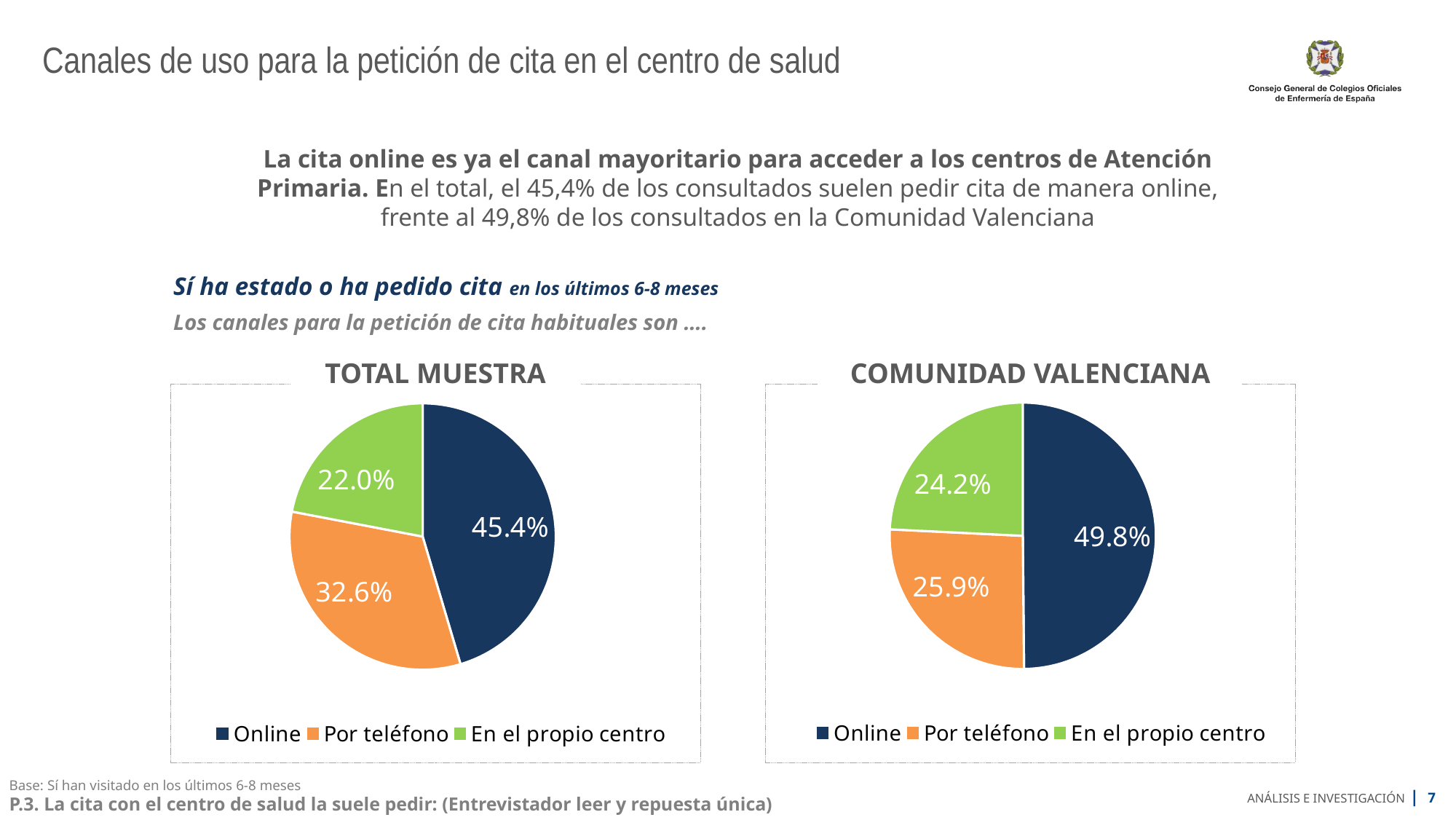
In the TOTAL MUESTRA chart, what percentage is shown for Online? 45.4% In the TOTAL MUESTRA chart, what is the difference between the Online and Por teléfono percentages? 12.8% In the TOTAL MUESTRA chart, what percentage is shown for Por teléfono? 32.6% In the COMUNIDAD VALENCIANA chart, what percentage is shown for Por teléfono? 25.9% In the COMUNIDAD VALENCIANA chart, what is the difference between the Online and En el propio centro percentages? 25.6% What type of chart is used in the TOTAL MUESTRA chart? Pie chart Which chart shows a higher percentage for Online, TOTAL MUESTRA or COMUNIDAD VALENCIANA? COMUNIDAD VALENCIANA In the TOTAL MUESTRA chart, which category has the largest slice? Online In the COMUNIDAD VALENCIANA chart, which category has the largest slice? Online How many categories does the legend of the COMUNIDAD VALENCIANA chart list? 3 In the TOTAL MUESTRA chart, which category has the smallest slice? En el propio centro In the COMUNIDAD VALENCIANA chart, what percentage is shown for En el propio centro? 24.2%